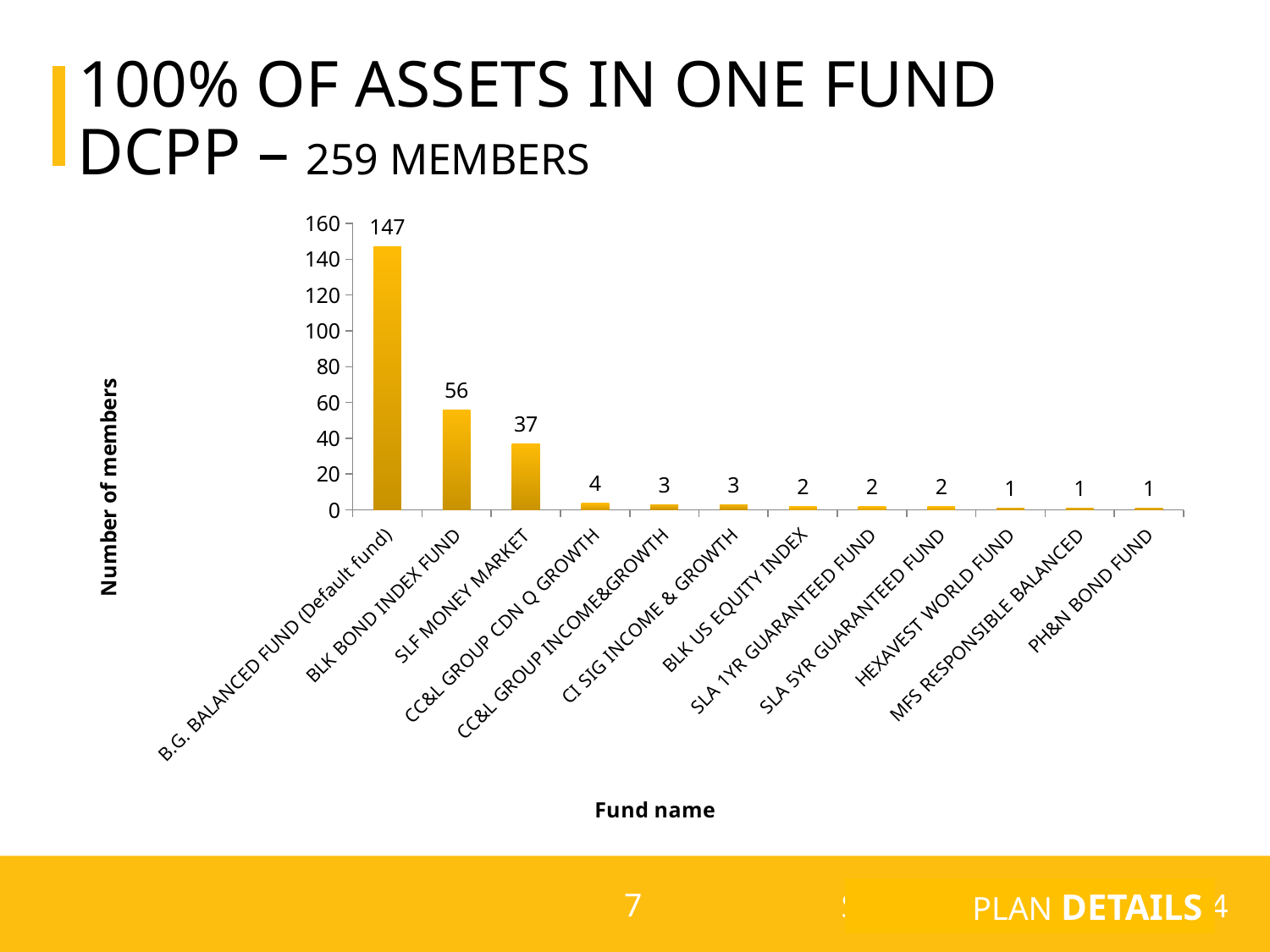
What kind of chart is shown on the slide? bar chart Do the values rise or fall from left to right along the x axis? fall What is the number of members for PH&N BOND FUND? 1 Which fund has the highest number of members? B.G. BALANCED FUND (Default fund) What is the difference in number of members between BLK BOND INDEX FUND and SLF MONEY MARKET? 19 What is the number of members for BLK BOND INDEX FUND? 56 How many funds are shown on the x axis of the chart? 12 How many members have 100% of assets in the B.G. BALANCED FUND (Default fund)? 147 What is the label of the vertical axis of the chart? Number of members Is the value for B.G. BALANCED FUND (Default fund) greater or less than 140? greater Which has more members, CC&L GROUP CDN Q GROWTH or CI SIG INCOME & GROWTH? CC&L GROUP CDN Q GROWTH What is the number of members for SLF MONEY MARKET? 37